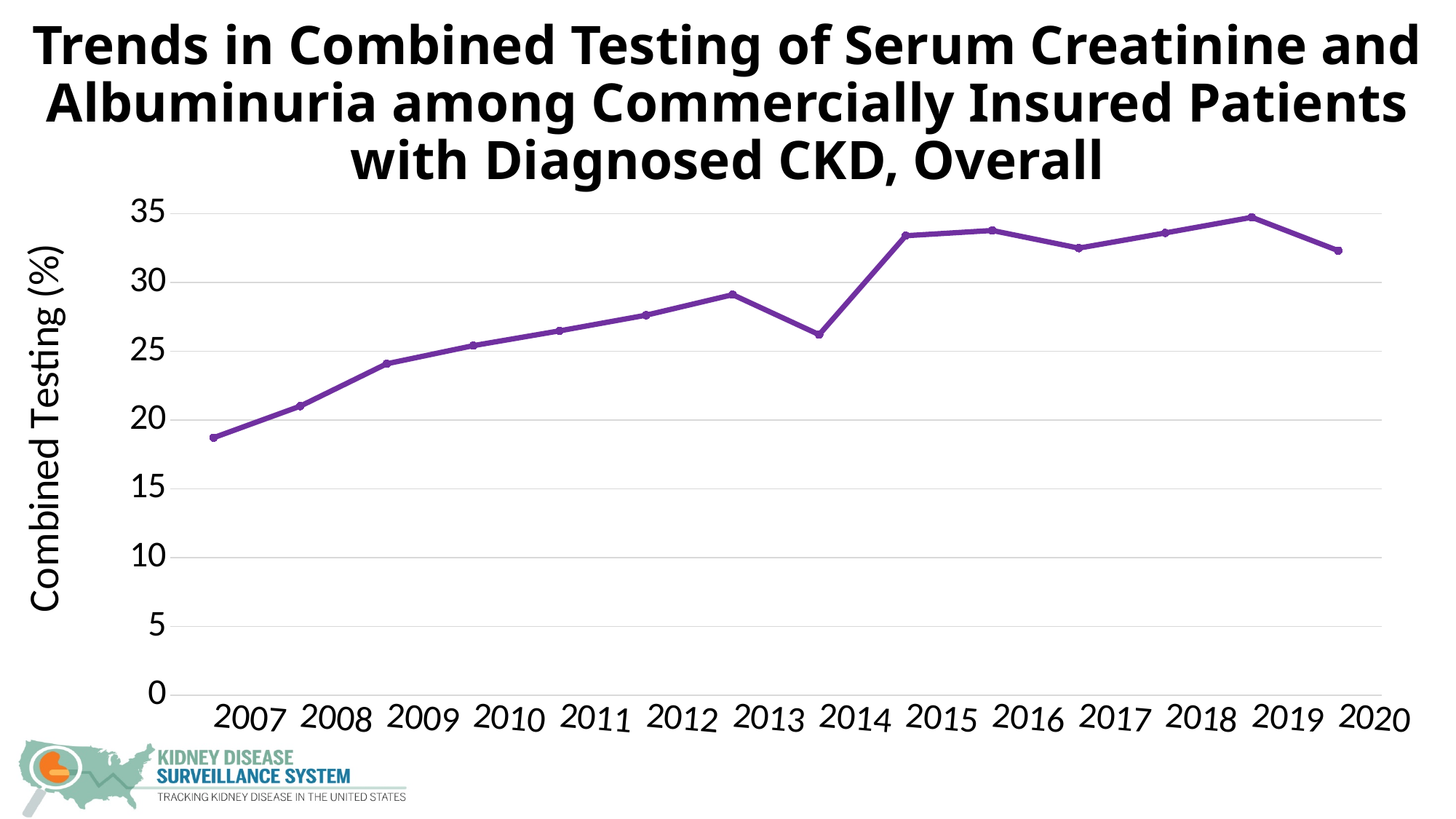
Do the values rise or fall from 2007 to 2013? Rise Which year has the larger value, 2007 or 2020? 2020 Is the value for 2009 greater or less than 25? less Is the value for 2007 greater or less than 20? less Is the value for 2015 greater or less than 30? greater What is the label on the y axis? Combined Testing (%) How many years are plotted along the x axis? 14 Which year has the highest combined testing percentage? 2019 Which year has the lowest combined testing percentage? 2007 What kind of chart is shown on the slide? Line chart Which year has the larger value, 2013 or 2014? 2013